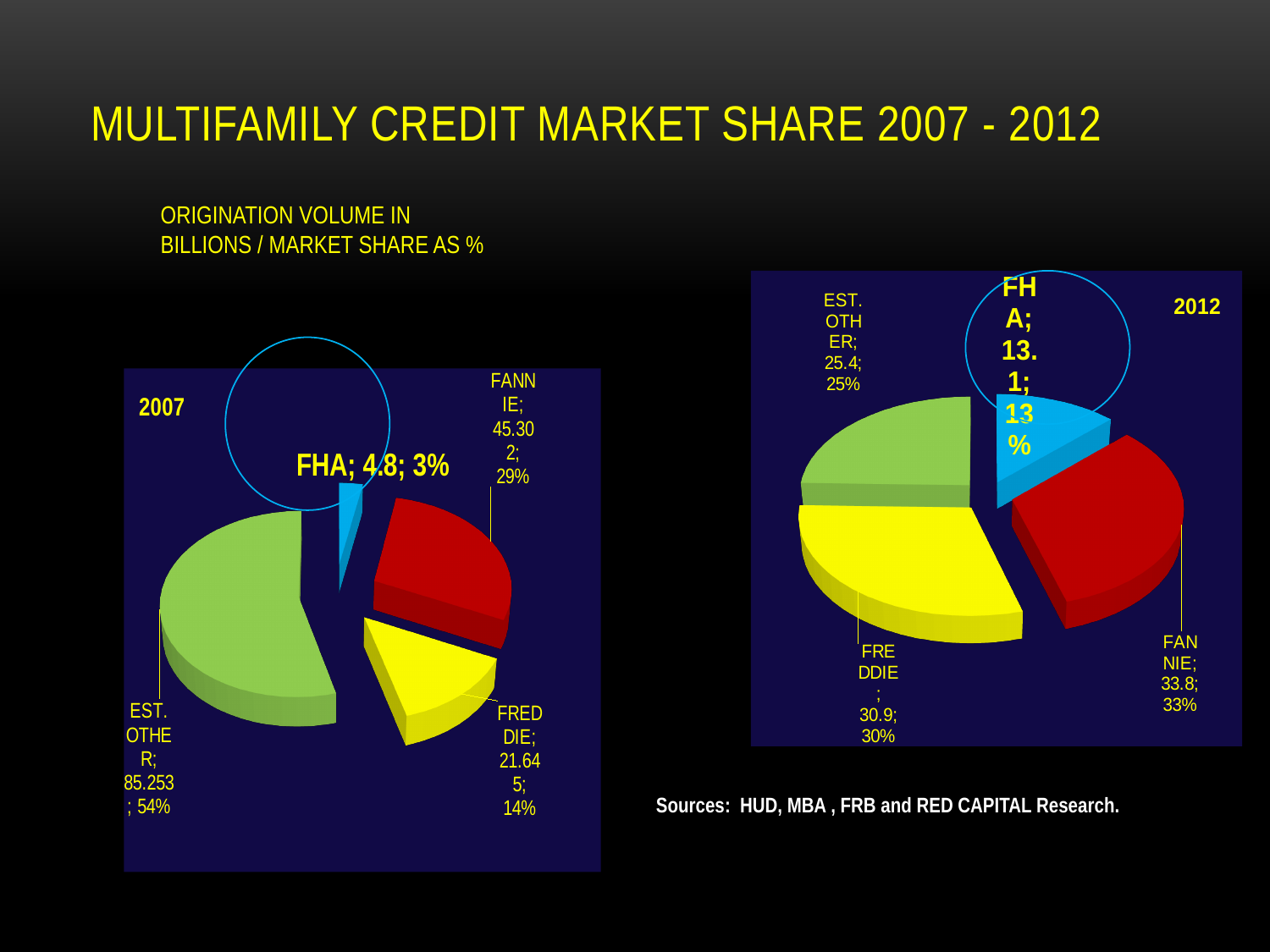
In the 2007 pie chart, what is the origination volume for FHA? 4.8 In the 2007 pie chart, which category has the smallest share? FHA In the 2012 pie chart, what market share does FANNIE hold? 33% In the 2012 pie chart, what is the origination volume for FREDDIE? 30.9 What type of chart is used to show the 2012 market share? Pie chart How many slices does the 2007 pie chart have? 4 In the 2012 pie chart, which category has the smallest share? FHA In the 2007 pie chart, what is the origination volume for FANNIE? 45.302 In the 2007 pie chart, which category has the largest share? EST. OTHER In the 2012 pie chart, what is the origination volume for FHA? 13.1 In the 2007 pie chart, what market share does EST. OTHER hold? 54% In the 2012 pie chart, what is the difference in origination volume between FANNIE and FREDDIE? 2.9